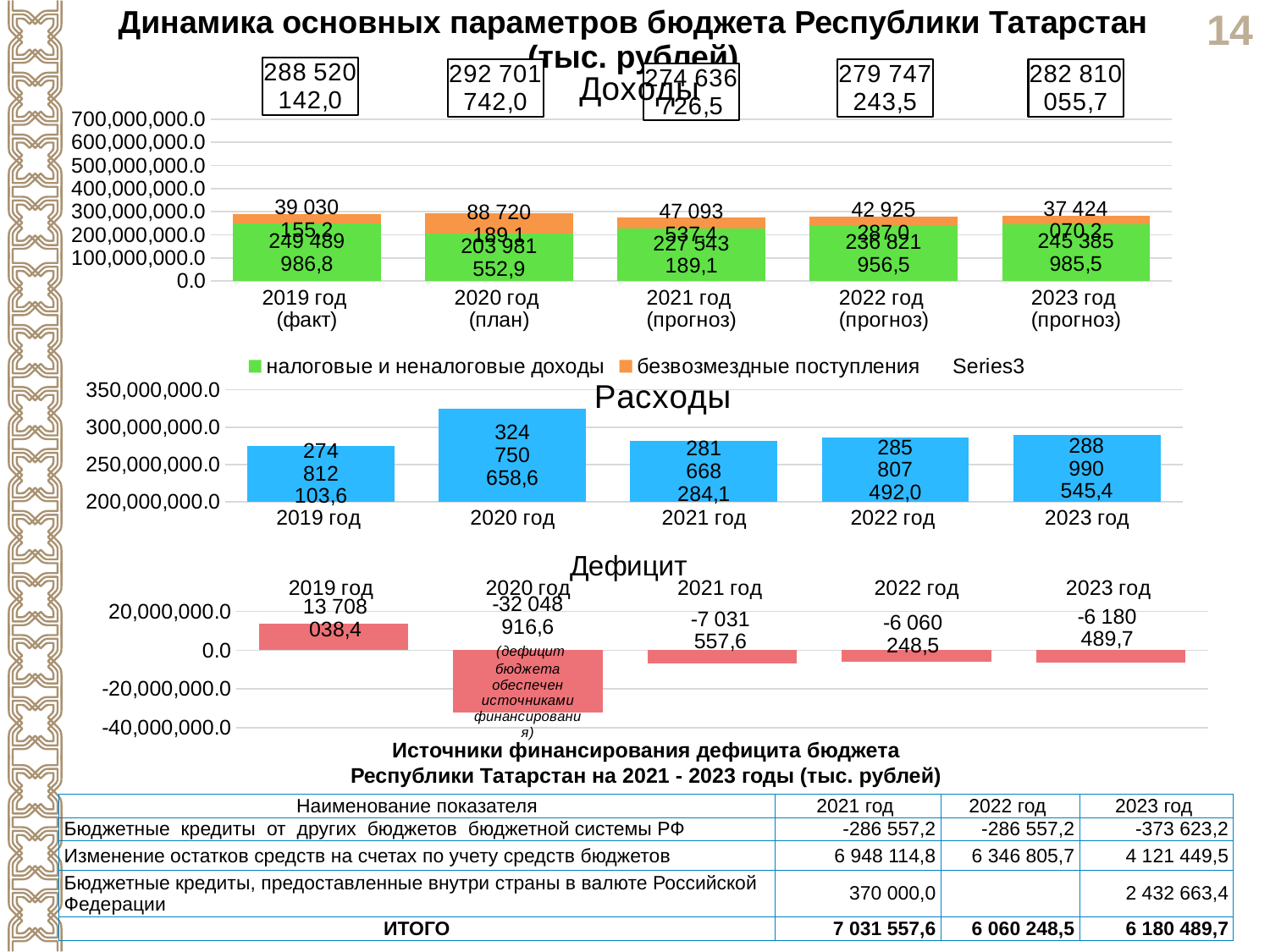
On the Доходы chart, how many series does the legend list? 3 On the Расходы chart, which year has the lowest value? 2019 год On the Доходы chart, how many categories are shown on the x axis? 5 On the Расходы chart, which year has the highest value? 2020 год On the Дефицит chart, which year has the only positive value? 2019 год On the Доходы chart, what is the value of налоговые и неналоговые доходы for 2023 год (прогноз)? 245 385 985,5 On the Доходы chart, in which year is безвозмездные поступления the highest? 2020 год (план) On the Доходы chart, what is the value of безвозмездные поступления for 2020 год (план)? 88 720 189,1 On the Дефицит chart, what is the value for 2020 год? -32 048 916,6 On the Расходы chart, what is the value for 2020 год? 324 750 658,6 On the Расходы chart, is the value for 2021 год greater or less than 300,000,000.0? less What type of chart is the Расходы chart? bar chart